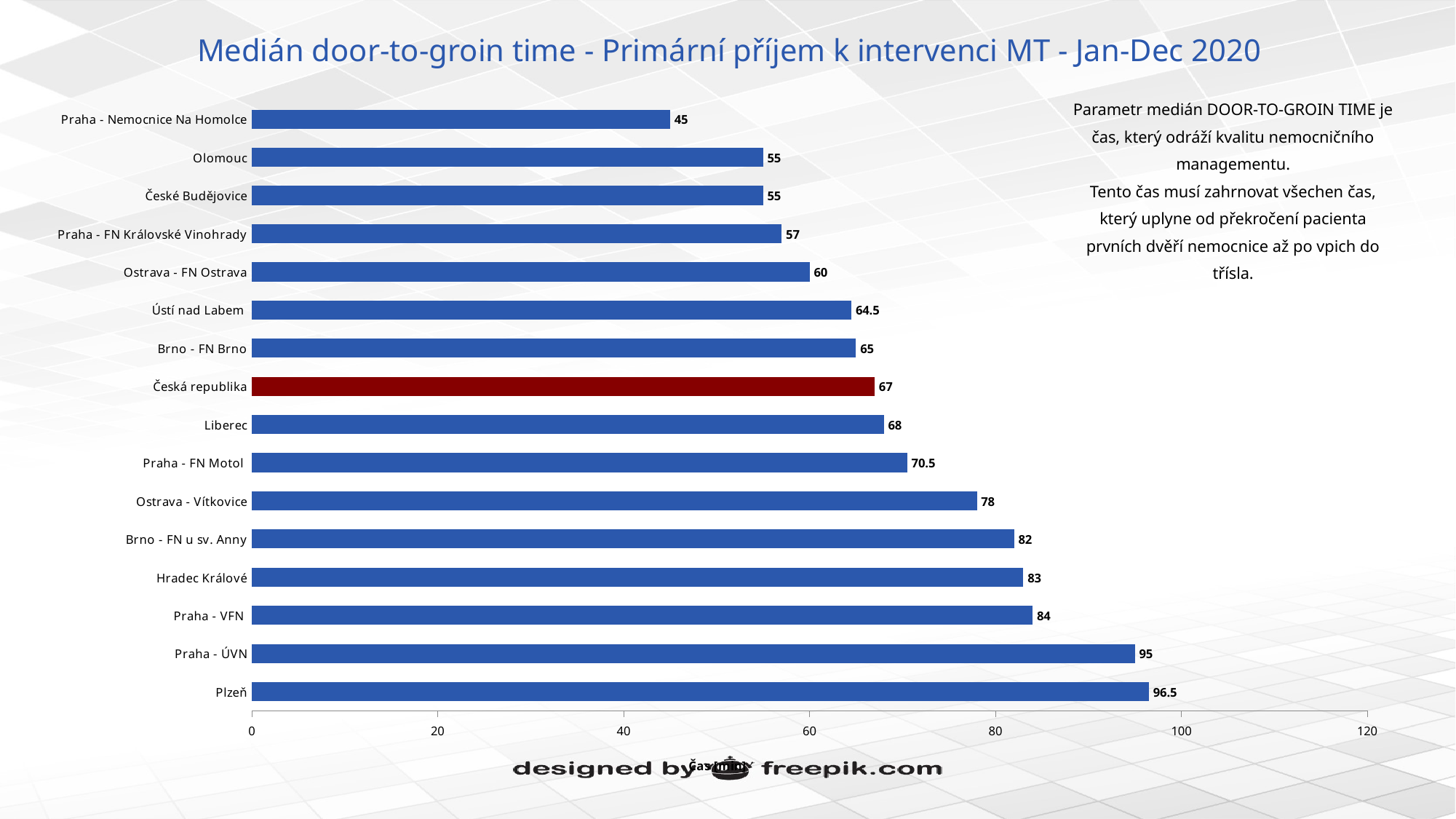
What is the median door-to-groin time for Praha - Nemocnice Na Homolce? 45 What is the value shown for Česká republika? 67 Which category has the highest value? Plzeň What is the difference between the values for Plzeň and Praha - Nemocnice Na Homolce? 51.5 What kind of chart is shown on the slide? bar chart Which category has the lowest value? Praha - Nemocnice Na Homolce Is the value for Ostrava - Vítkovice greater or less than 80? less Which bar is shown in a different colour (dark red) from the others? Česká republika How many categories are shown in the chart? 16 Which has a larger value, Praha - ÚVN or Hradec Králové? Praha - ÚVN What is the value shown for Praha - FN Motol? 70.5 What is the value shown for Ústí nad Labem? 64.5